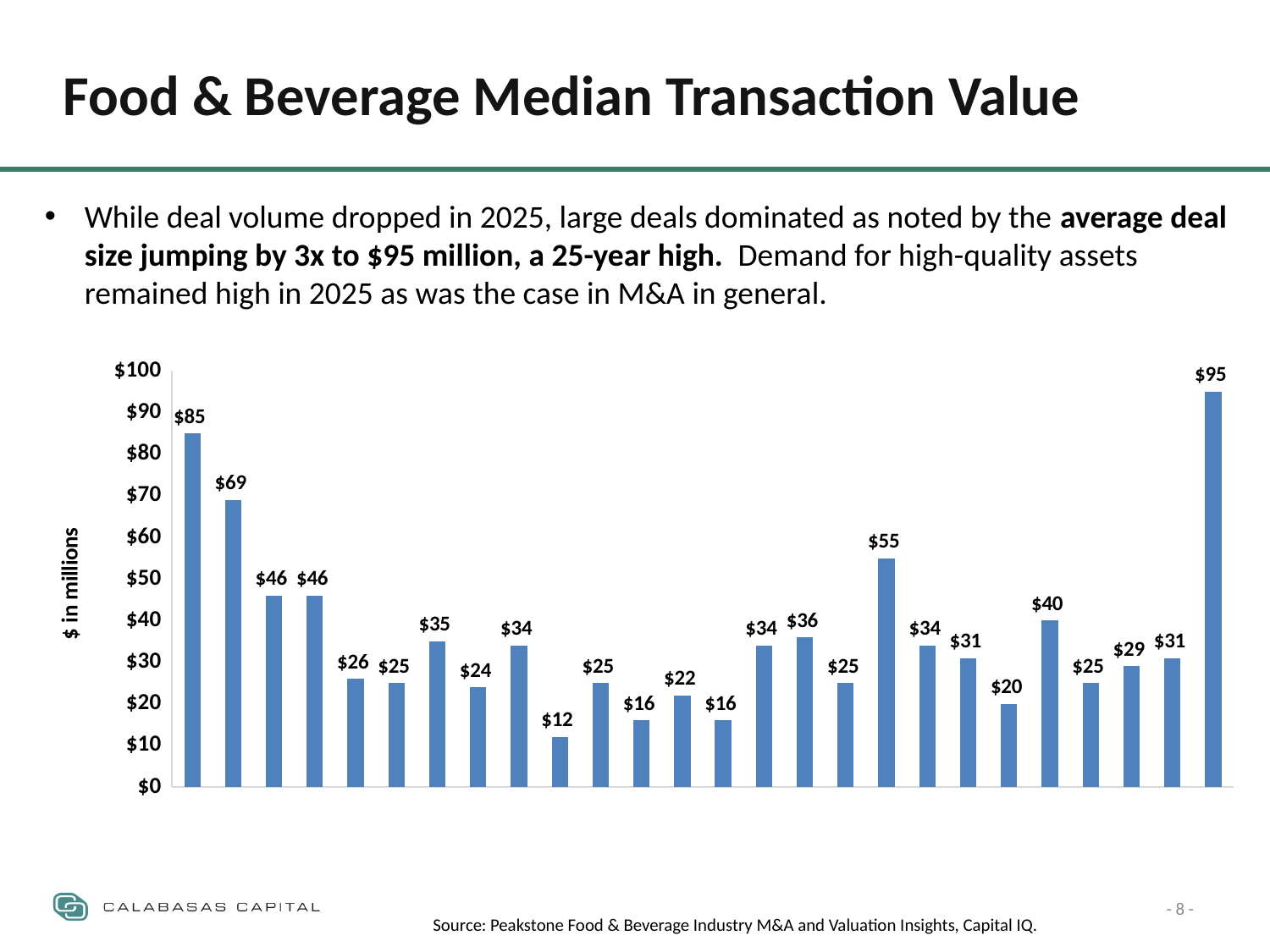
Is the value of the rightmost bar greater or less than $90? greater What is the lowest value shown in the chart? $12 Which is larger, the leftmost bar or the rightmost bar? the rightmost bar What type of chart is shown on the slide? bar chart What is the value of the leftmost bar in the chart? $85 What is the maximum value shown on the vertical axis? $100 What is the label on the vertical axis of the chart? $ in millions What is the value of the rightmost bar in the chart? $95 What is the highest value shown in the chart? $95 What is the value of the second bar from the left? $69 What is the difference between the rightmost bar ($95) and the leftmost bar ($85)? $10 How many bars are plotted in the chart? 26